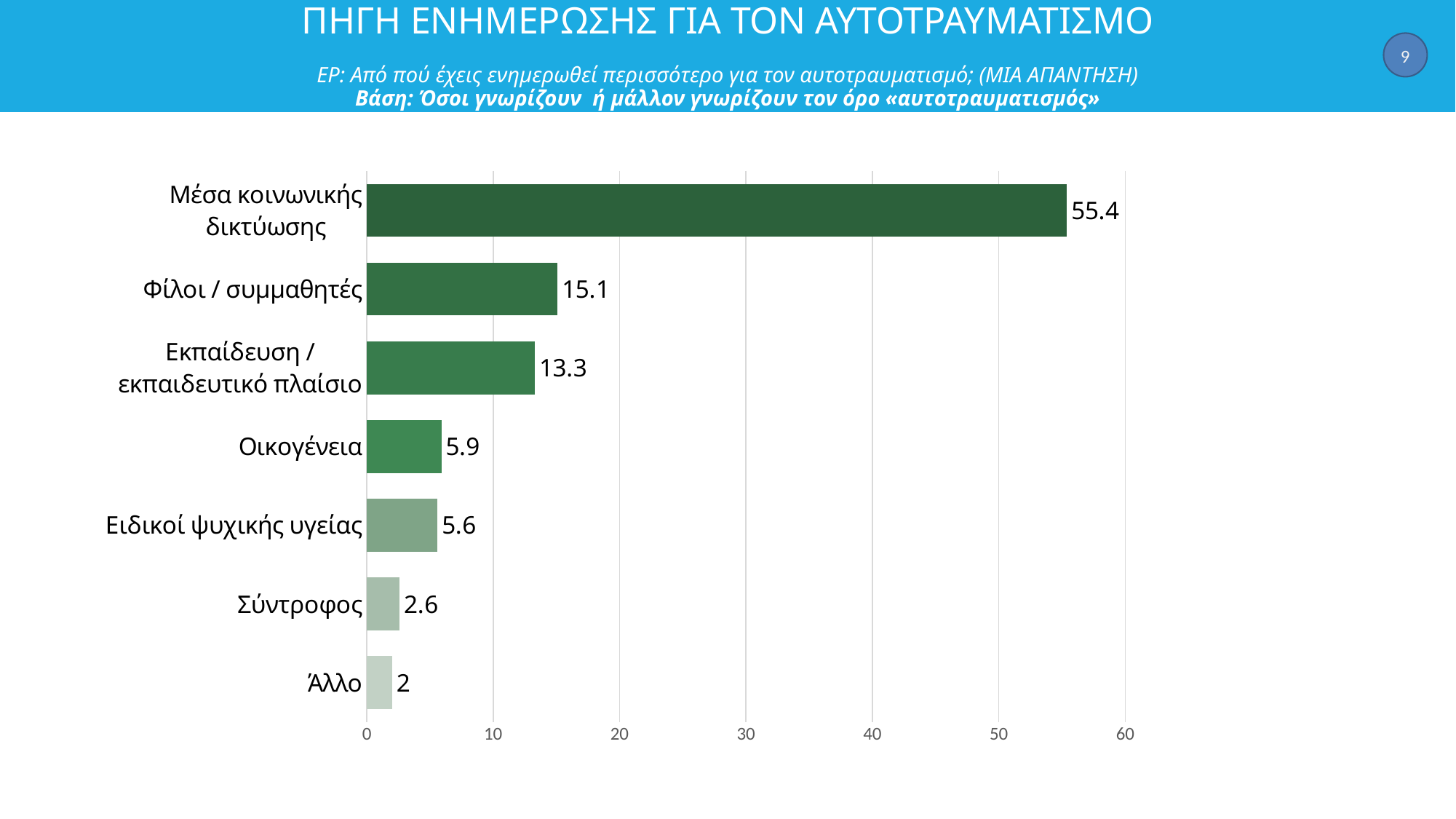
What is the value for Φίλοι / συμμαθητές? 15.1 Which category has the lowest value? Άλλο What is the difference between the values for Μέσα κοινωνικής δικτύωσης and Φίλοι / συμμαθητές? 40.3 What is the difference between the values for Οικογένεια and Σύντροφος? 3.3 How many categories are shown in the chart? 7 Is the value for Μέσα κοινωνικής δικτύωσης greater or less than 50? greater What kind of chart is shown on the slide? bar chart What is the value for Μέσα κοινωνικής δικτύωσης? 55.4 Which is larger, the value for Φίλοι / συμμαθητές or the value for Εκπαίδευση / εκπαιδευτικό πλαίσιο? Φίλοι / συμμαθητές What is the value for Εκπαίδευση / εκπαιδευτικό πλαίσιο? 13.3 What is the value for Ειδικοί ψυχικής υγείας? 5.6 Which category has the highest value? Μέσα κοινωνικής δικτύωσης